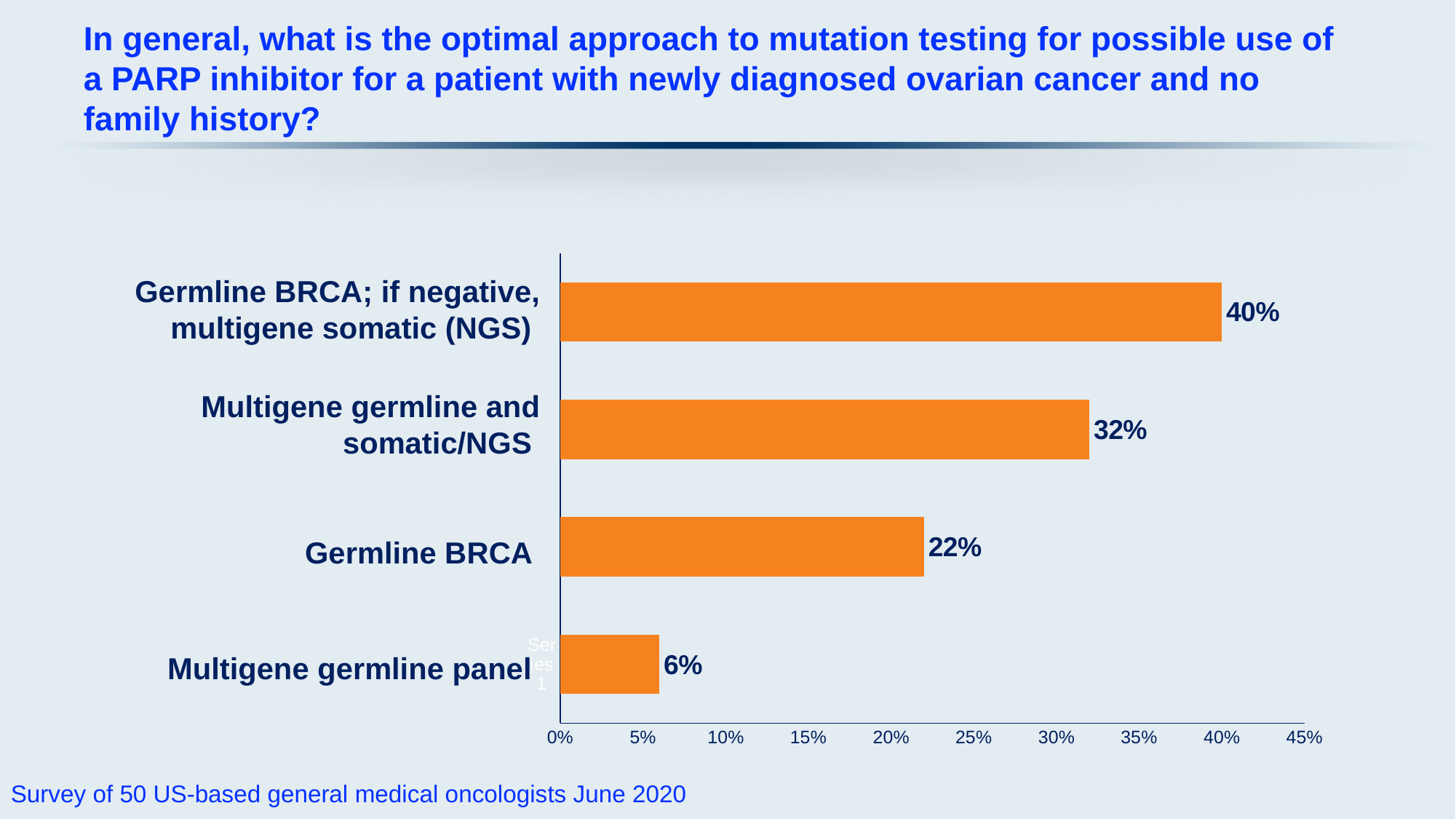
Which is larger: the value for "Multigene germline and somatic/NGS" or the value for "Germline BRCA"? Multigene germline and somatic/NGS How many approaches (categories) are shown in the chart? 4 Which approach has the highest percentage? Germline BRCA; if negative, multigene somatic (NGS) What kind of chart is shown on the slide? Bar chart What is the value for "Multigene germline and somatic/NGS"? 32% Which approach has the lowest percentage? Multigene germline panel What is the value for "Germline BRCA"? 22% What is the value for "Multigene germline panel"? 6% What percentage of respondents chose "Germline BRCA; if negative, multigene somatic (NGS)"? 40% What is the difference between the values for "Multigene germline and somatic/NGS" and "Multigene germline panel"? 26% What is the maximum value shown on the x axis? 45% What is the difference between the values for "Germline BRCA; if negative, multigene somatic (NGS)" and "Germline BRCA"? 18%